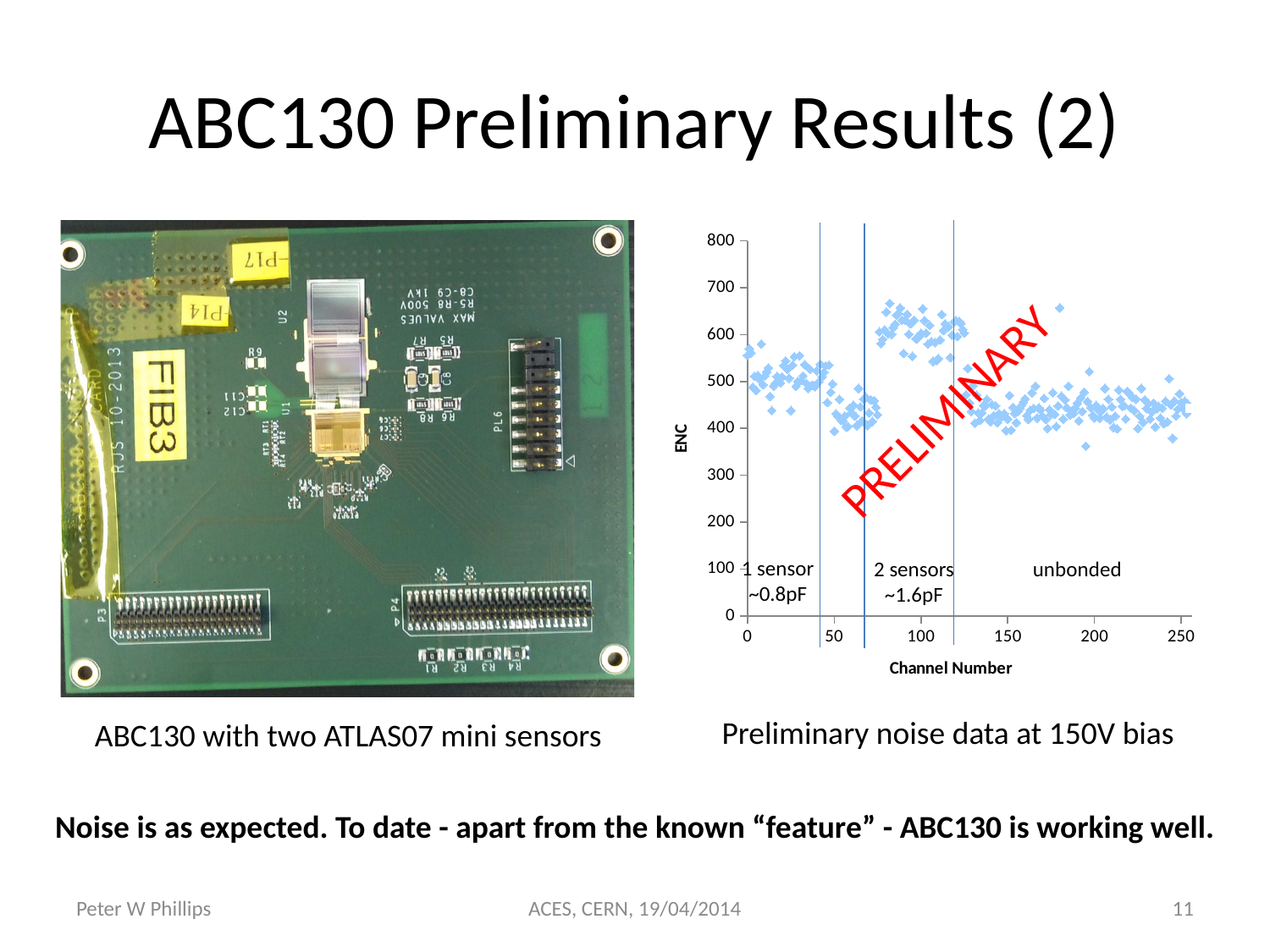
What capacitance is noted for the '1 sensor' region of the chart? ~0.8pF Do the ENC values rise or fall when moving from the '2 sensors' region to the 'unbonded' region along the Channel Number axis? fall What is the label of the vertical axis of the chart? ENC How many labelled regions (sensor configurations) are marked on the chart? 3 Are the ENC values in the 'unbonded' region of the chart greater or less than 600? less What capacitance is noted for the '2 sensors' region of the chart? ~1.6pF Are the ENC values in the '2 sensors' region of the chart greater or less than 500? greater What is the label of the horizontal axis of the chart? Channel Number What is the highest value shown on the Channel Number axis of the chart? 250 What is the highest value shown on the ENC axis of the chart? 800 Which region of the chart shows higher ENC values, '2 sensors' or 'unbonded'? 2 sensors What kind of chart is shown on the right of the slide? scatter chart